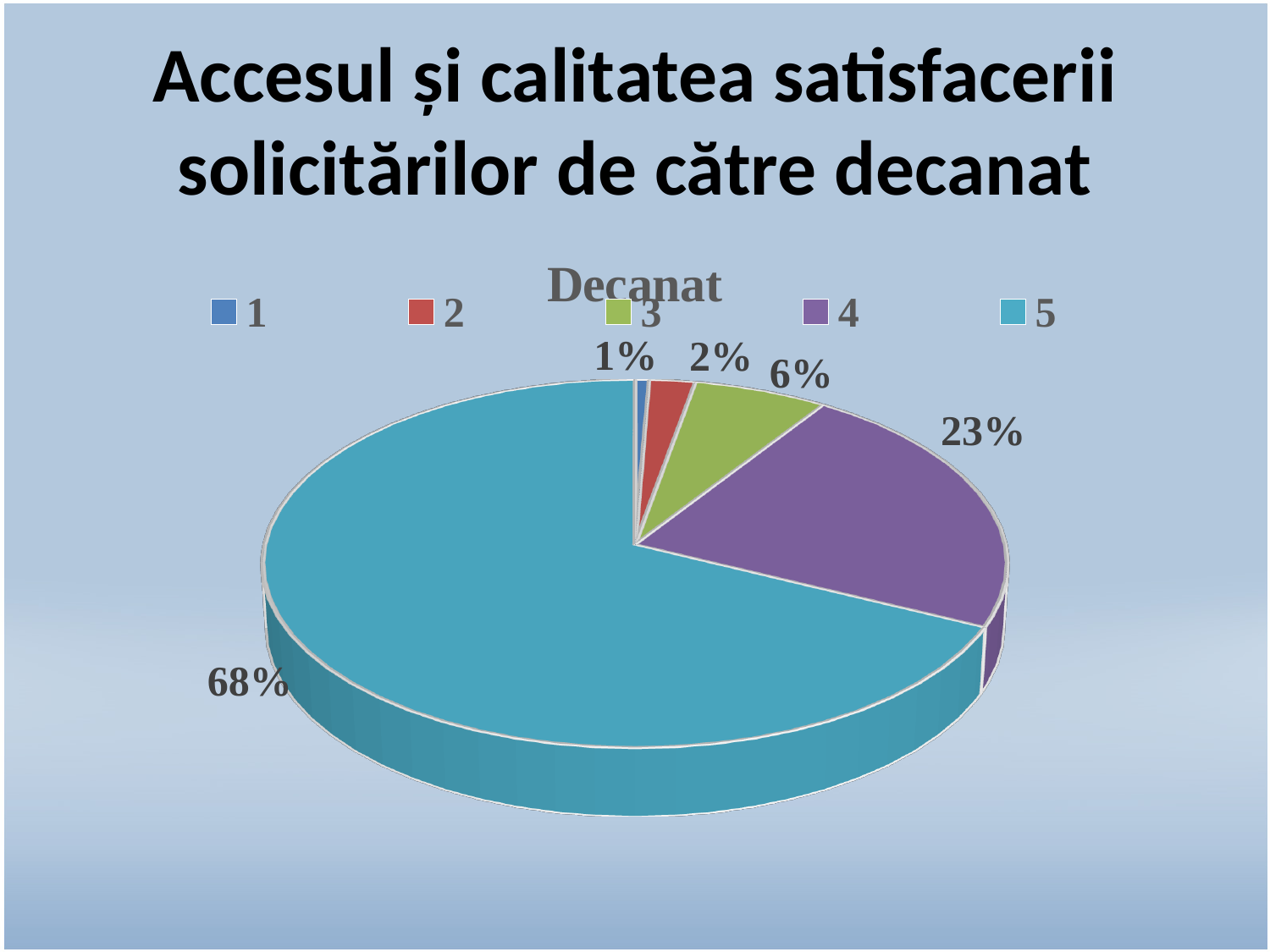
What kind of chart is shown on the slide? pie chart Which category has the largest slice? 5 What share of the pie does category 1 have? 1% What share of the pie does category 3 have? 6% What is the difference between the shares of category 5 and category 4? 45% What share of the pie does category 4 have? 23% Which category has the smallest slice? 1 What is the chart's title? Decanat Which is larger, the share of category 3 or category 2? 3 How many categories does the legend list? 5